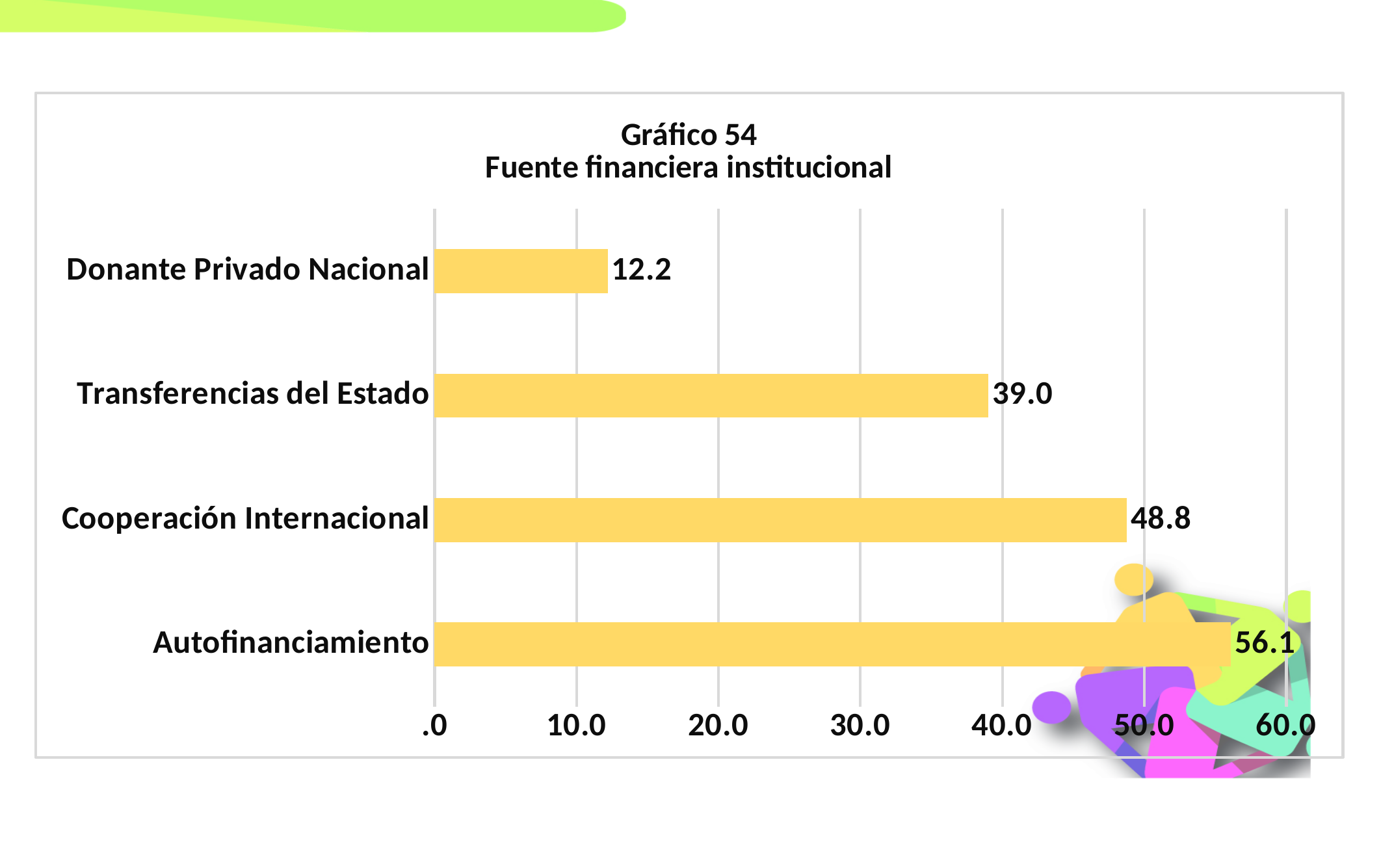
What is the difference between the values for Transferencias del Estado and Donante Privado Nacional? 26.8 What is the value for Cooperación Internacional? 48.8 How many categories are shown in the chart? 4 Which category has the highest value? Autofinanciamiento Is the value for Transferencias del Estado greater or less than 40.0? less What is the value for Donante Privado Nacional? 12.2 What is the difference between the values for Autofinanciamiento and Cooperación Internacional? 7.3 Which category has the lowest value? Donante Privado Nacional What kind of chart is shown on the slide? bar chart What is the value for Autofinanciamiento? 56.1 What is the value for Transferencias del Estado? 39.0 Which is larger, the value for Cooperación Internacional or the value for Transferencias del Estado? Cooperación Internacional